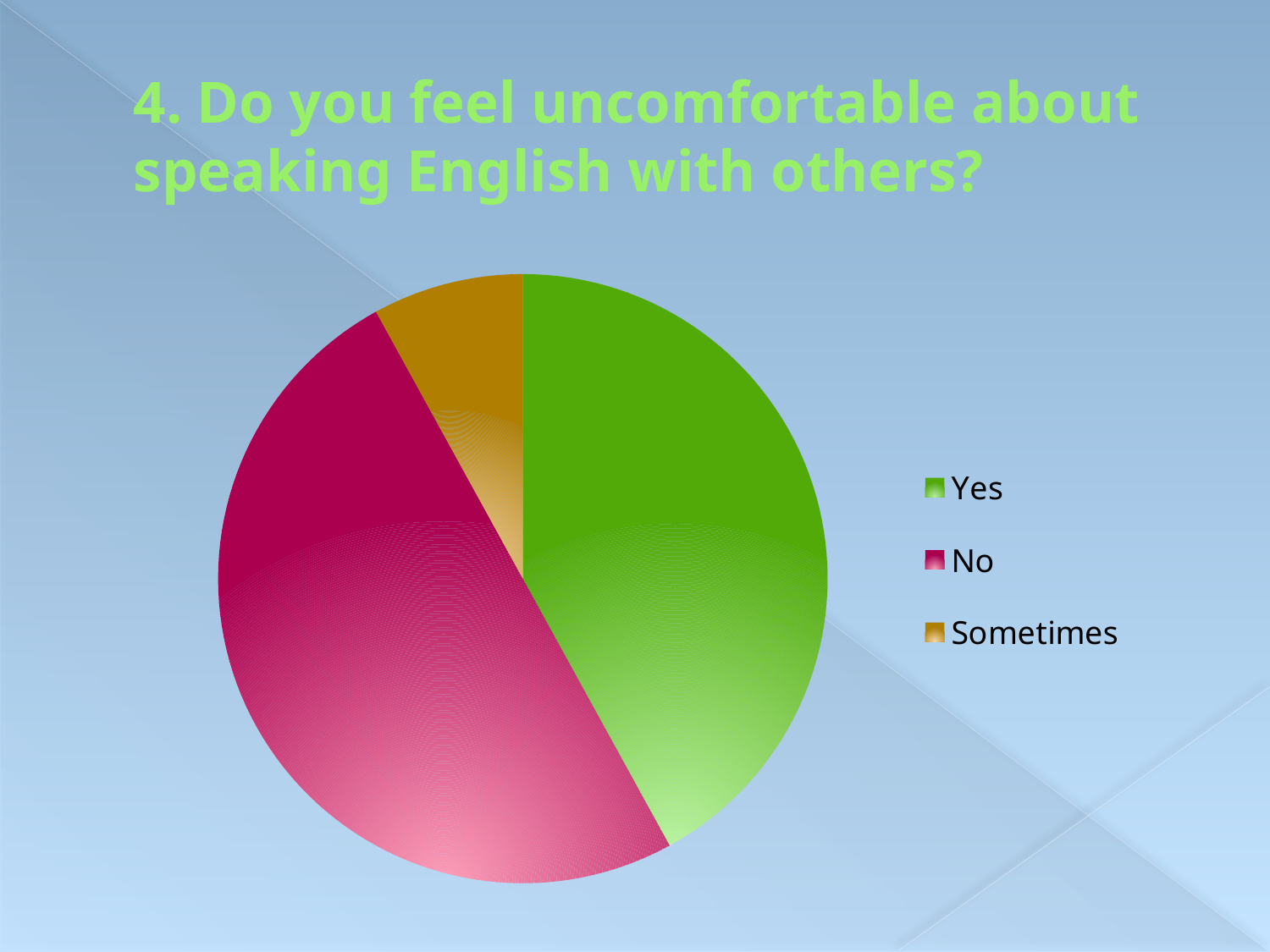
Which slice is larger, No or Sometimes? No Which slice is larger, Yes or Sometimes? Yes Which category has the smallest slice of the pie? Sometimes What colour is the slice for Sometimes? gold What question does the chart title ask? 4. Do you feel uncomfortable about speaking English with others? How many entries does the legend list? 3 What kind of chart is shown on the slide? pie chart How many slices does the pie chart have? 3